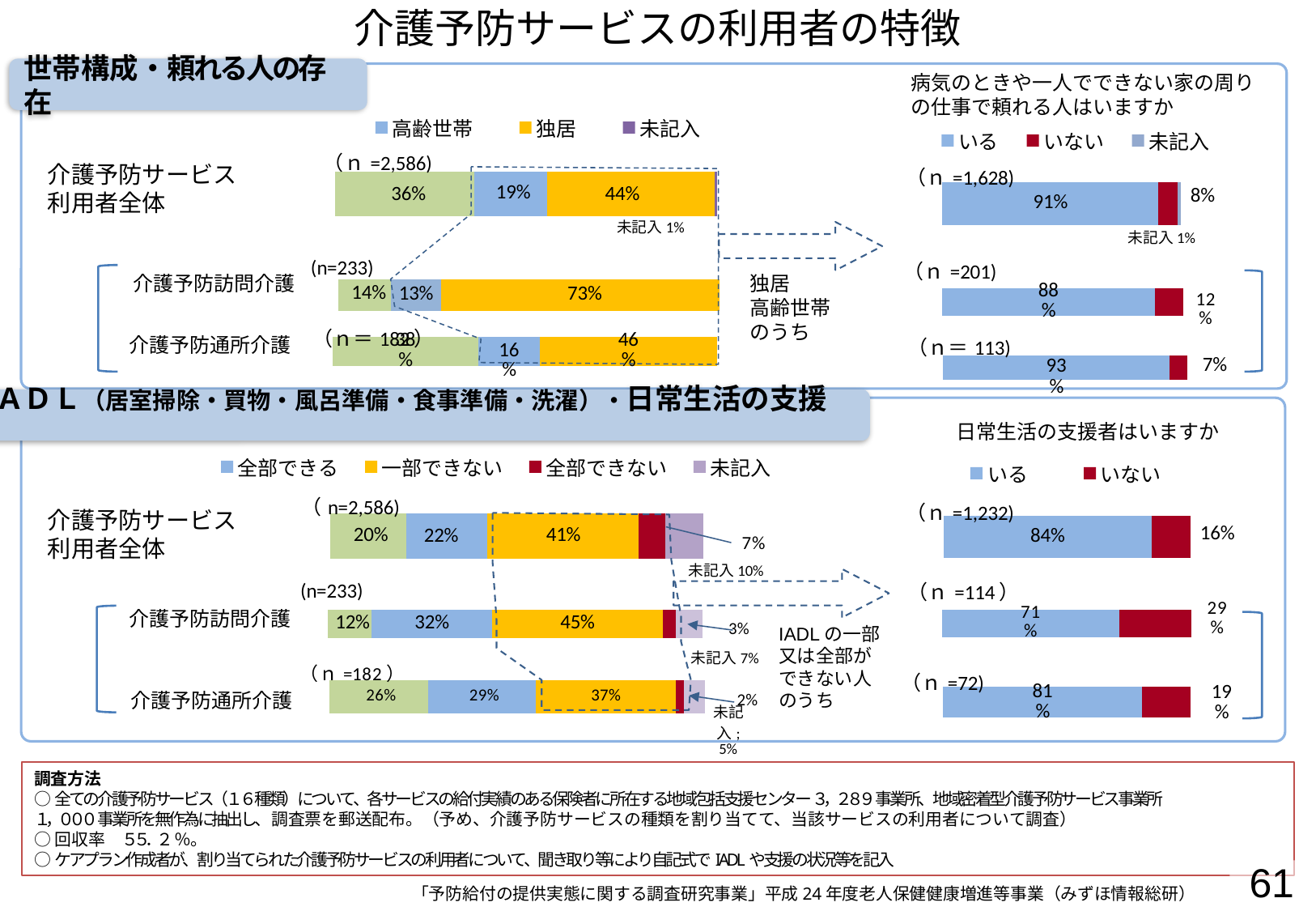
In the top-right chart (頼れる人はいますか), what percentage of 介護予防訪問介護 users answered いない? 12% In the top-right chart (病気のときや一人でできない家の周りの仕事で頼れる人はいますか), what percentage of 介護予防サービス利用者全体 answered いる? 91% How many series does the legend of the bottom-left IADL chart list? 4 In the bottom-right chart (日常生活の支援者はいますか), which group has the lowest いる percentage? 介護予防訪問介護 In the top-left household composition chart, what is the 高齢世帯 percentage for 介護予防サービス利用者全体? 19% In the top-left household composition chart, what is the difference between the 独居 percentage for 介護予防訪問介護 and for 介護予防サービス利用者全体? 29 percentage points In the top-left household composition chart, what is the 独居 percentage for 介護予防訪問介護? 73% In the top-right chart (頼れる人はいますか), which of the three groups has the highest いる percentage? 介護予防通所介護 In the bottom-left IADL chart, what percentage of 介護予防訪問介護 users are 一部できない? 45% In the bottom-right chart (日常生活の支援者はいますか), what percentage of 介護予防訪問介護 users answered いない? 29% In the bottom-left IADL chart, what percentage of 介護予防通所介護 users are 全部できない? 2% In the bottom-left IADL chart, which group has the highest 全部できる percentage? 介護予防訪問介護